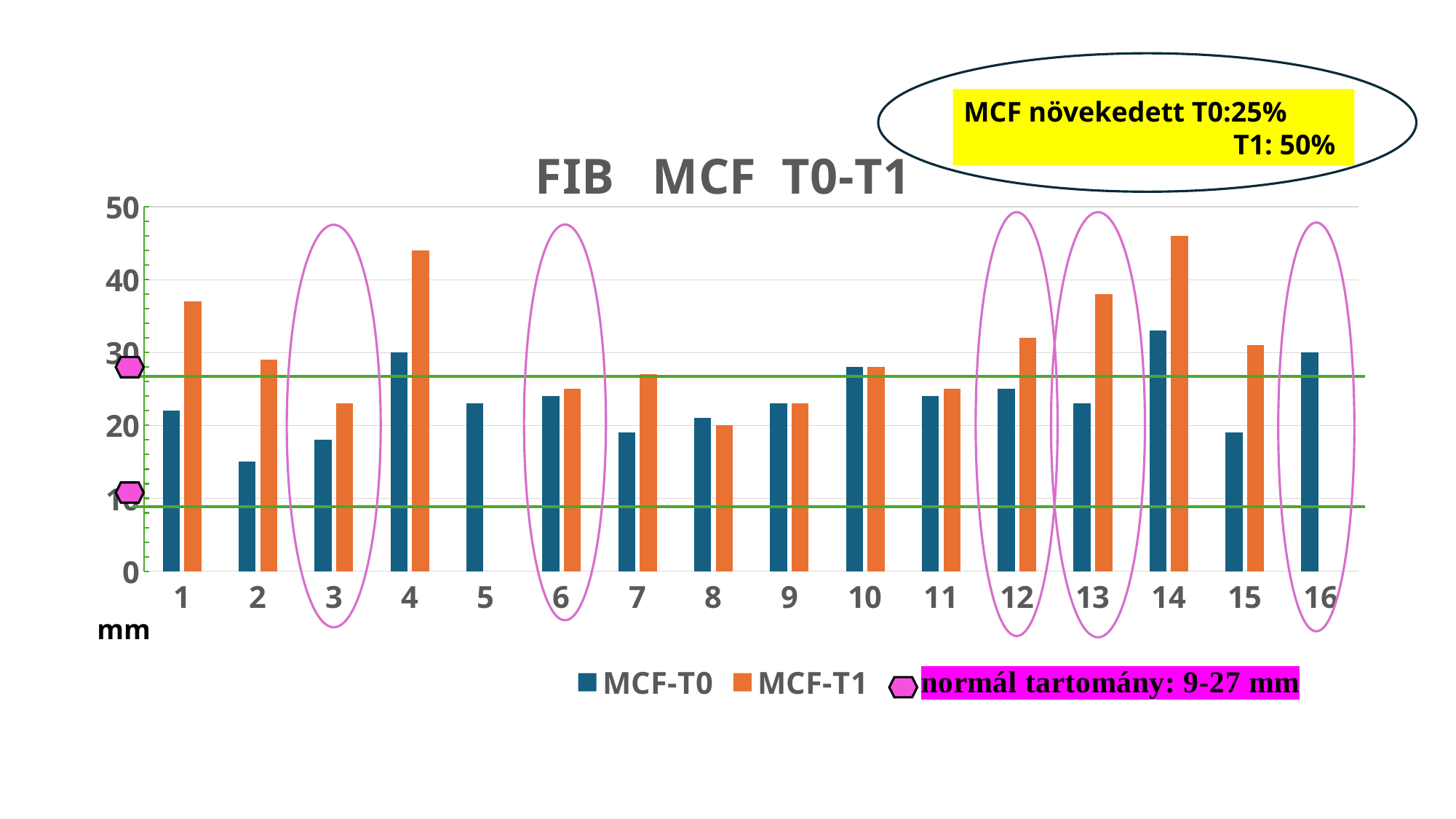
Is the MCF-T1 value for category 13 greater or less than 30? greater Which category has the lowest MCF-T0 value? 2 Is the MCF-T0 value for category 2 greater or less than 20? less Which category has the highest MCF-T1 value? 14 What is the title of the chart? FIB MCF T0-T1 Is the MCF-T1 value for category 1 greater or less than 30? greater What unit is shown for the vertical axis of the chart? mm What kind of chart is shown on the slide? bar chart For category 3, which series has the larger value, MCF-T0 or MCF-T1? MCF-T1 Which category has the highest MCF-T0 value? 14 How many categories are shown on the x axis of the chart? 16